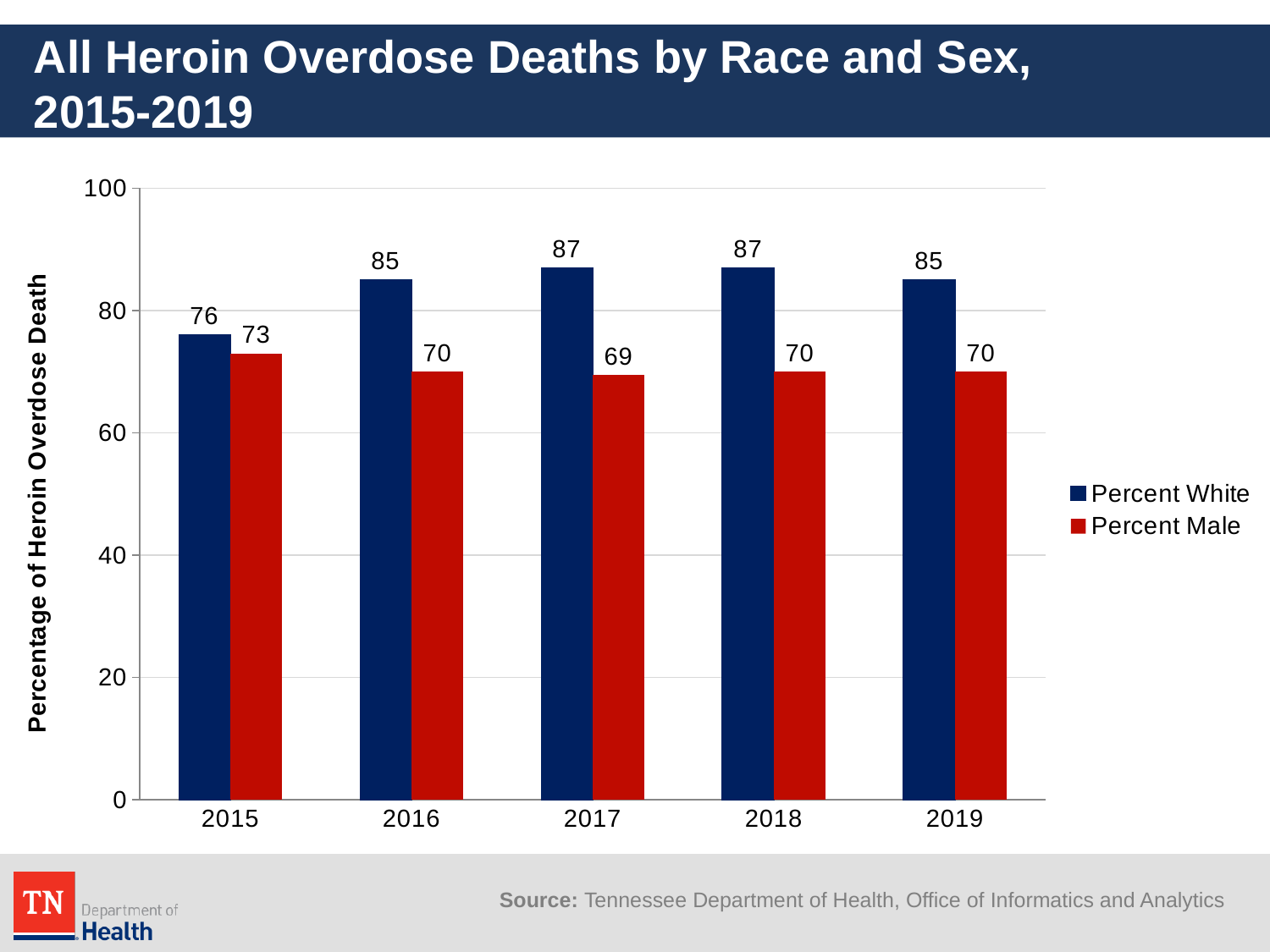
Which year has the highest Percent Male value? 2015 How many series does the legend list? 2 What is the Percent White value for 2015? 76 What is the Percent Male value for 2017? 69 What is the Percent White value for 2019? 85 What is the difference between Percent White and Percent Male in 2018? 17 Which is larger in 2016, Percent White or Percent Male? Percent White How many years are shown on the x axis? 5 What is the label of the vertical axis? Percentage of Heroin Overdose Death What is the difference between the Percent White values for 2015 and 2017? 11 Which year has the lowest Percent White value? 2015 What kind of chart is shown on the slide? Bar chart